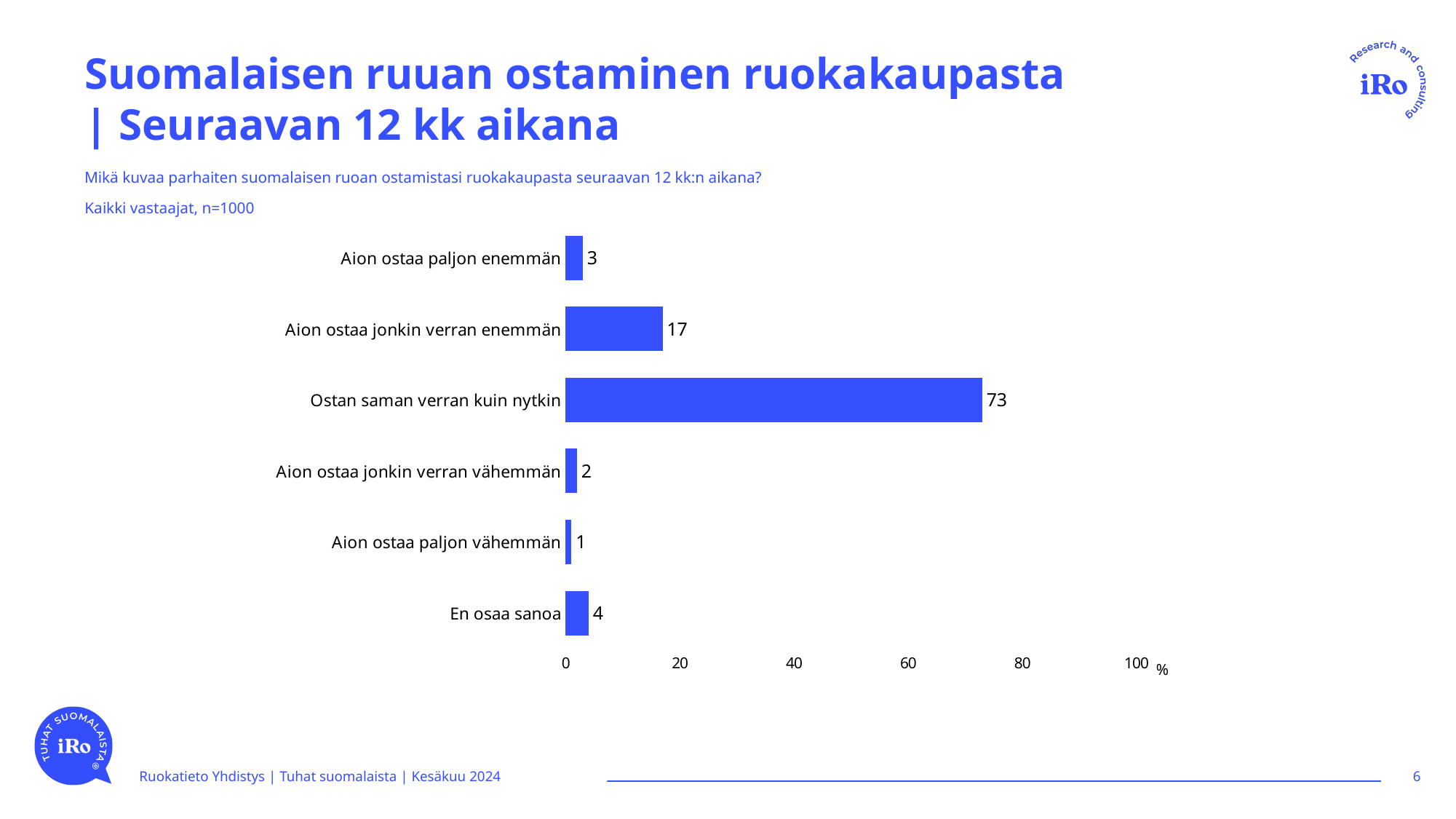
How many categories are shown in the chart? 6 What is the sample size stated above the chart? n=1000 What is the value for "Aion ostaa paljon vähemmän"? 1 What is the value for "En osaa sanoa"? 4 Which is larger, "Aion ostaa paljon enemmän" or "Aion ostaa jonkin verran vähemmän"? Aion ostaa paljon enemmän What is the value for "Ostan saman verran kuin nytkin"? 73 Which category has the highest value? Ostan saman verran kuin nytkin What kind of chart is shown on the slide? bar chart What is the value for "Aion ostaa jonkin verran enemmän"? 17 What is the difference between "Ostan saman verran kuin nytkin" and "Aion ostaa jonkin verran enemmän"? 56 Which category has the lowest value? Aion ostaa paljon vähemmän Is the value for "Ostan saman verran kuin nytkin" greater or less than 60? greater